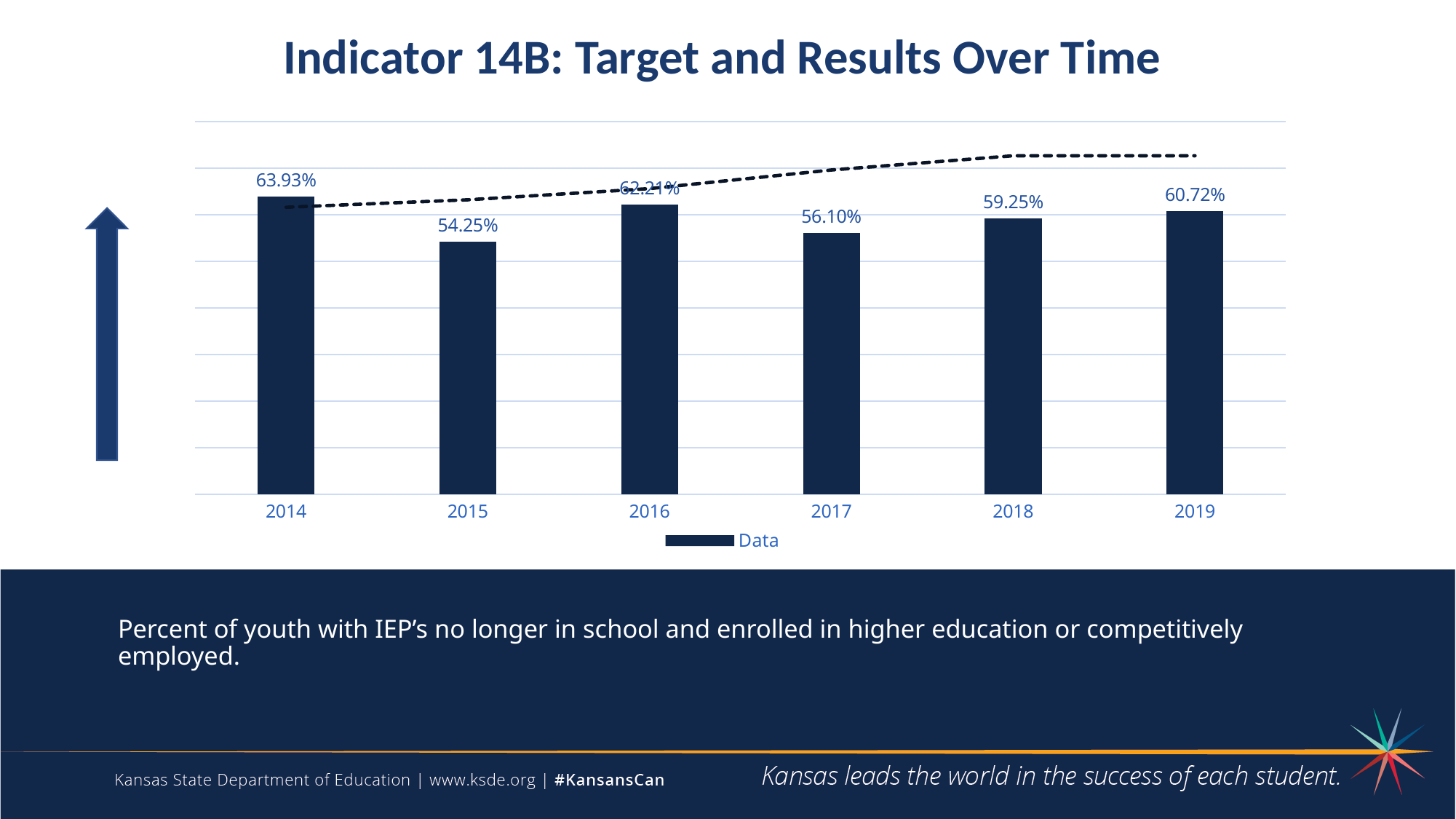
Which year has the lowest value? 2015 What is the value for 2015? 54.25% Which is larger, the value for 2016 or the value for 2017? 2016 What kind of chart is shown on the slide? Combination bar and line chart How many years are shown on the x axis? 6 What is the difference between the values for 2014 and 2015? 9.68% What is the value for 2017? 56.10% What is the title of the chart? Indicator 14B: Target and Results Over Time What is the value for 2019? 60.72% What is the value for 2014? 63.93% What is the difference between the values for 2019 and 2018? 1.47% Which year has the highest value? 2014